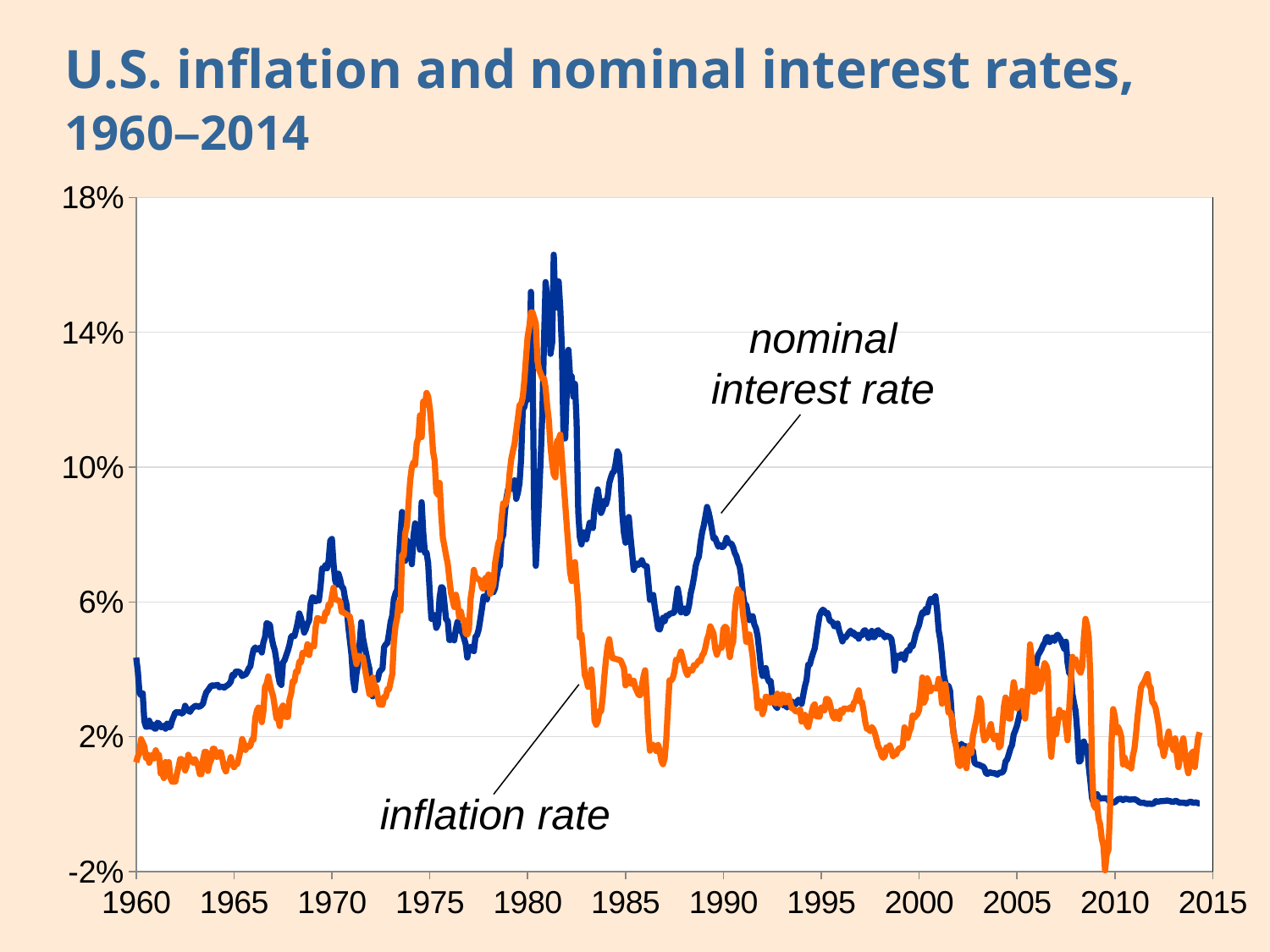
Does the nominal interest rate generally rise or fall from 1981 to 2014? fall In 1975, which is higher, the inflation rate or the nominal interest rate? inflation rate Is the nominal interest rate in 1990 greater or less than 6%? greater What kind of chart is shown on the slide? line chart Is the peak value of the nominal interest rate around 1981 greater or less than 14%? greater In 1985, which is higher, the nominal interest rate or the inflation rate? nominal interest rate What is the title of the chart? U.S. inflation and nominal interest rates, 1960–2014 How many series are plotted on the chart? 2 Is the nominal interest rate in 2012 greater or less than 2%? less Which series reaches the highest value on the chart? nominal interest rate Which series is drawn in orange? inflation rate